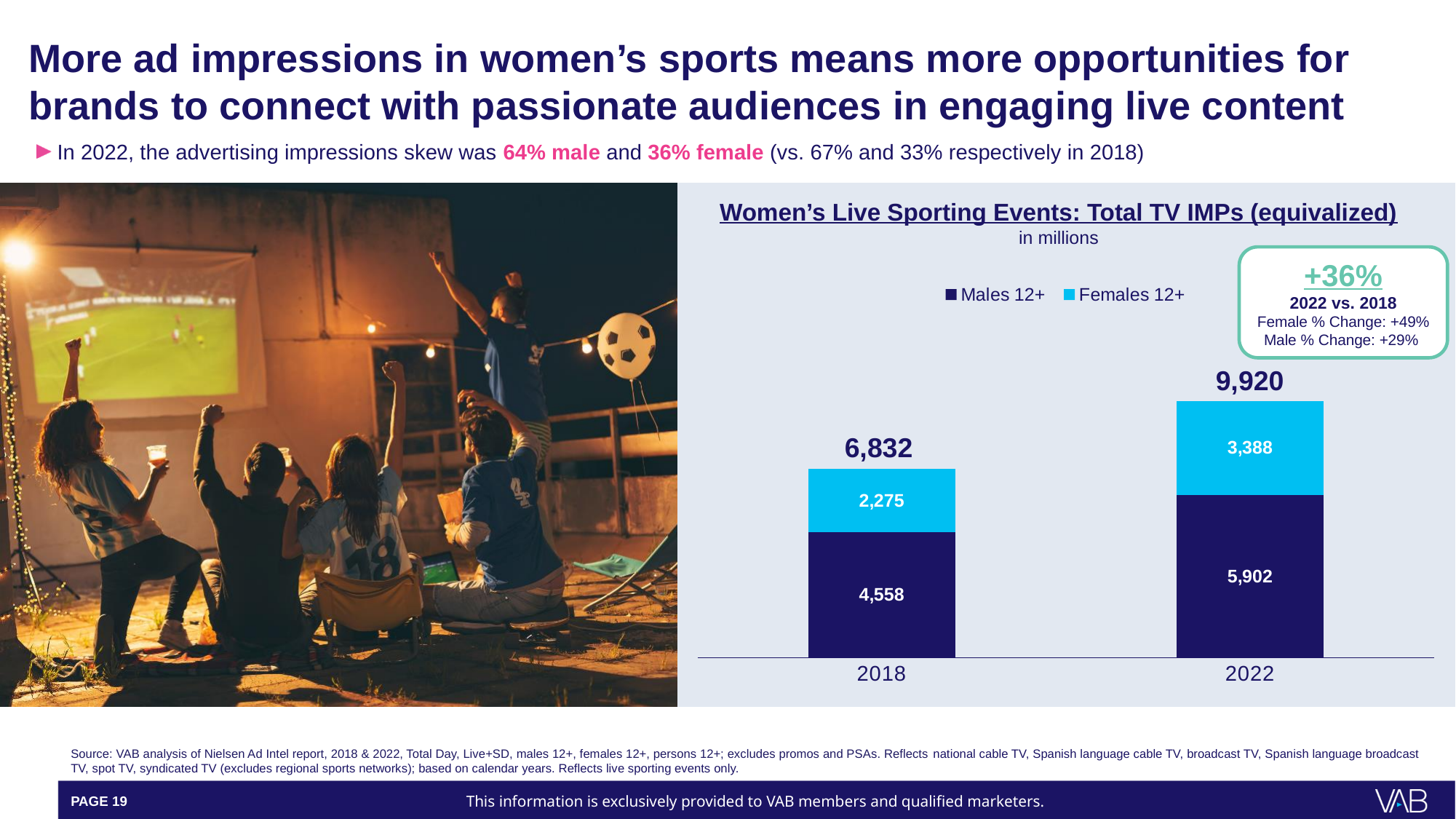
What is the value for Males 12+ in 2022? 5,902 What is the value for Females 12+ in 2018? 2,275 Which is larger in 2022, Males 12+ or Females 12+? Males 12+ What is the difference between the Females 12+ values for 2022 and 2018? 1,113 What is the difference between the Males 12+ values for 2022 and 2018? 1,344 What kind of chart is shown on the slide? Stacked bar chart How many series does the legend list? 2 What is the total of the stacked bar for 2022? 9,920 What is the total of the stacked bar for 2018? 6,832 Which year has the higher total TV impressions? 2022 What is the value for Males 12+ in 2018? 4,558 What is the value for Females 12+ in 2022? 3,388